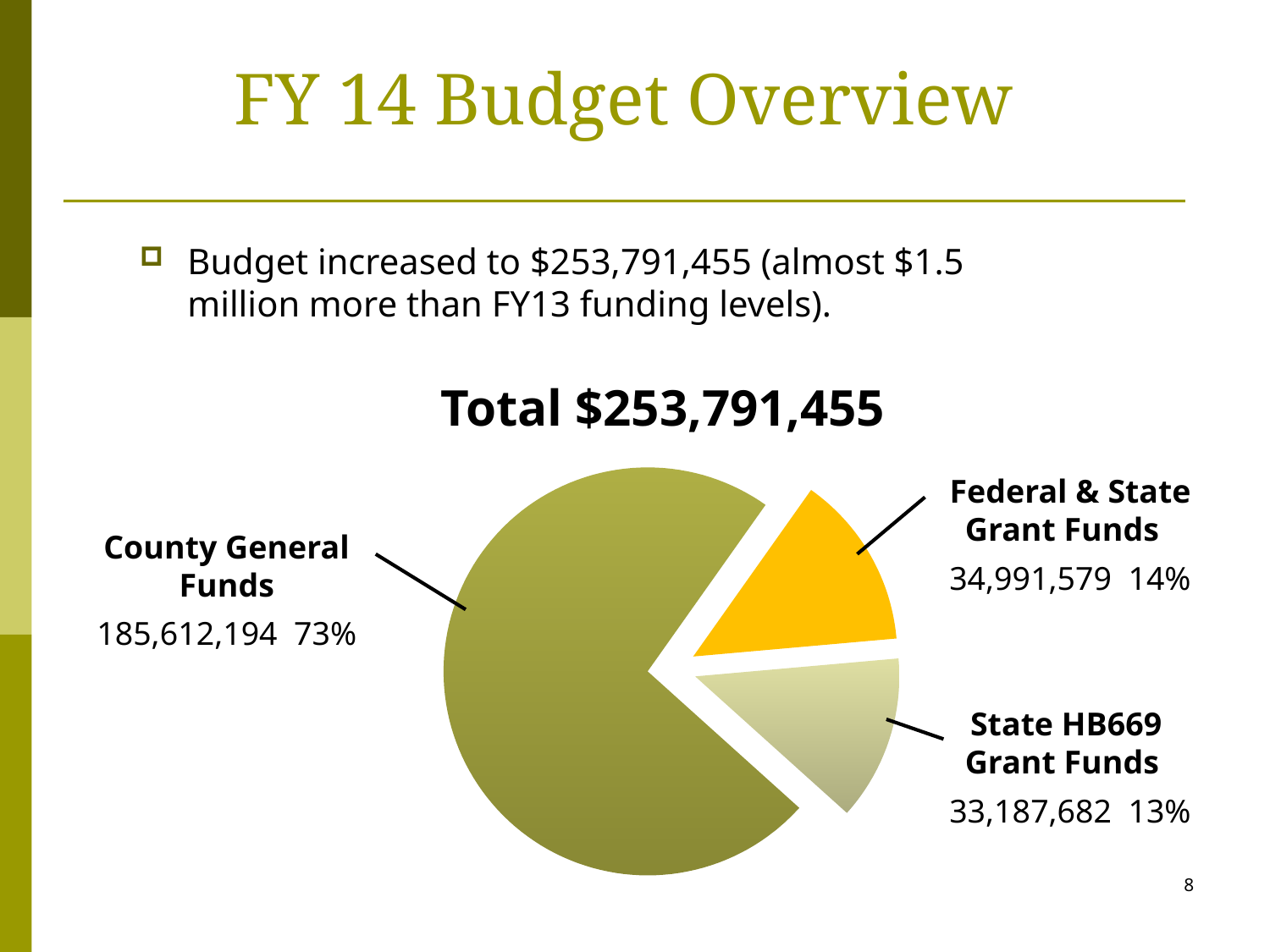
What share of the pie is County General Funds? 73% Which category has the largest slice of the pie? County General Funds What is the value for State HB669 Grant Funds? 33,187,682 What is the value for Federal & State Grant Funds? 34,991,579 What share of the pie is State HB669 Grant Funds? 13% What is the value for County General Funds? 185,612,194 Which slice is coloured yellow? Federal & State Grant Funds Which category has the smallest slice of the pie? State HB669 Grant Funds What kind of chart is shown on the slide? pie chart What total is shown in the chart title? $253,791,455 How many slices does the pie chart have? 3 What is the difference between the Federal & State Grant Funds value and the State HB669 Grant Funds value? 1,803,897